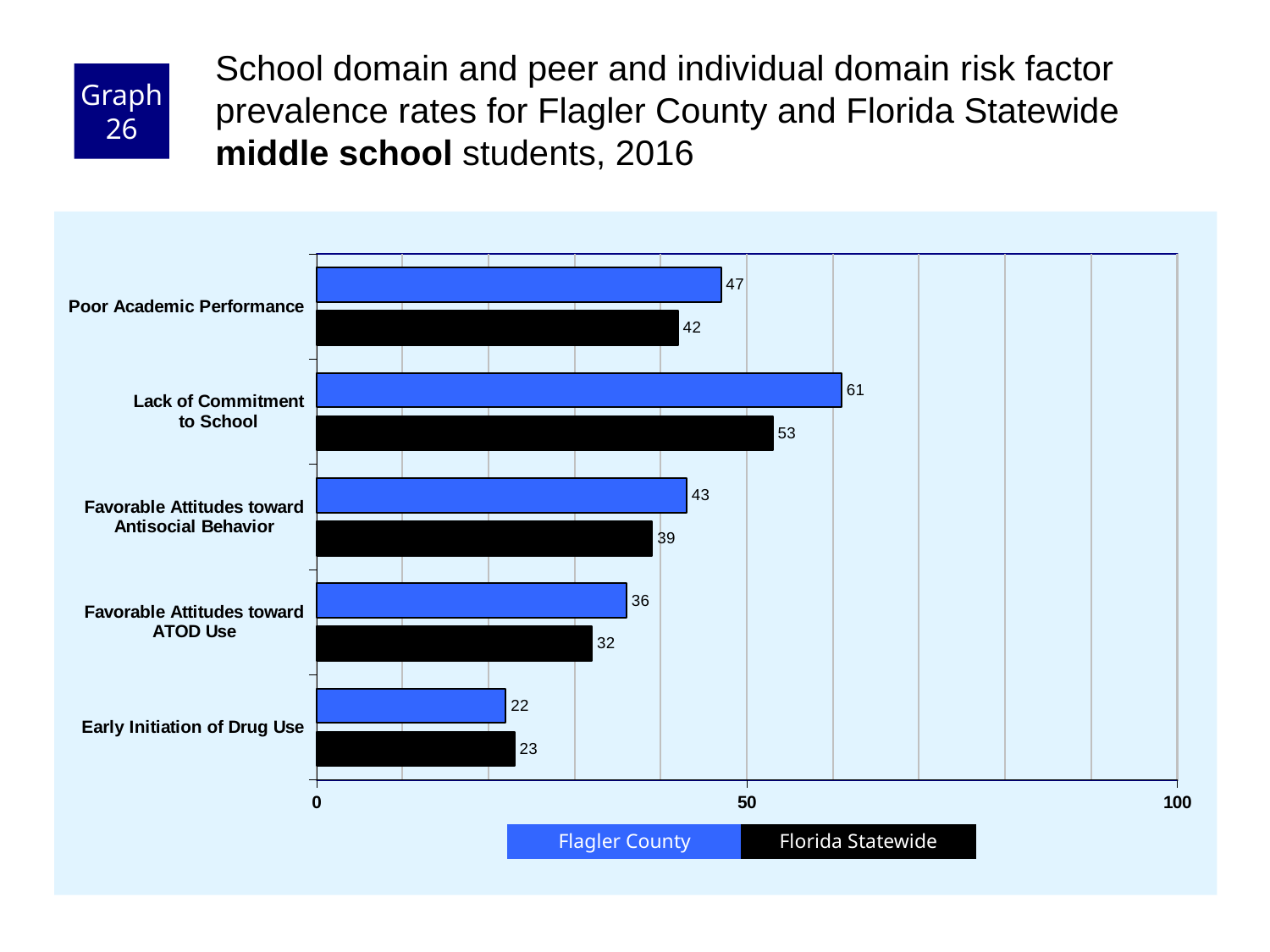
What is the difference between the Flagler County and Florida Statewide values for Poor Academic Performance? 5 How many series does the legend list? 2 How many risk factor categories are shown on the chart? 5 Which risk factor has the lowest Florida Statewide value? Early Initiation of Drug Use What is the Florida Statewide value for Favorable Attitudes toward ATOD Use? 32 Which colour represents Florida Statewide in the chart? black Is the Florida Statewide value for Lack of Commitment to School greater or less than 50? greater Which risk factor has the highest Flagler County value? Lack of Commitment to School What is the Florida Statewide value for Early Initiation of Drug Use? 23 Which is larger for Early Initiation of Drug Use: the Flagler County value or the Florida Statewide value? Florida Statewide What is the Flagler County value for Lack of Commitment to School? 61 What kind of chart is shown on the slide? bar chart